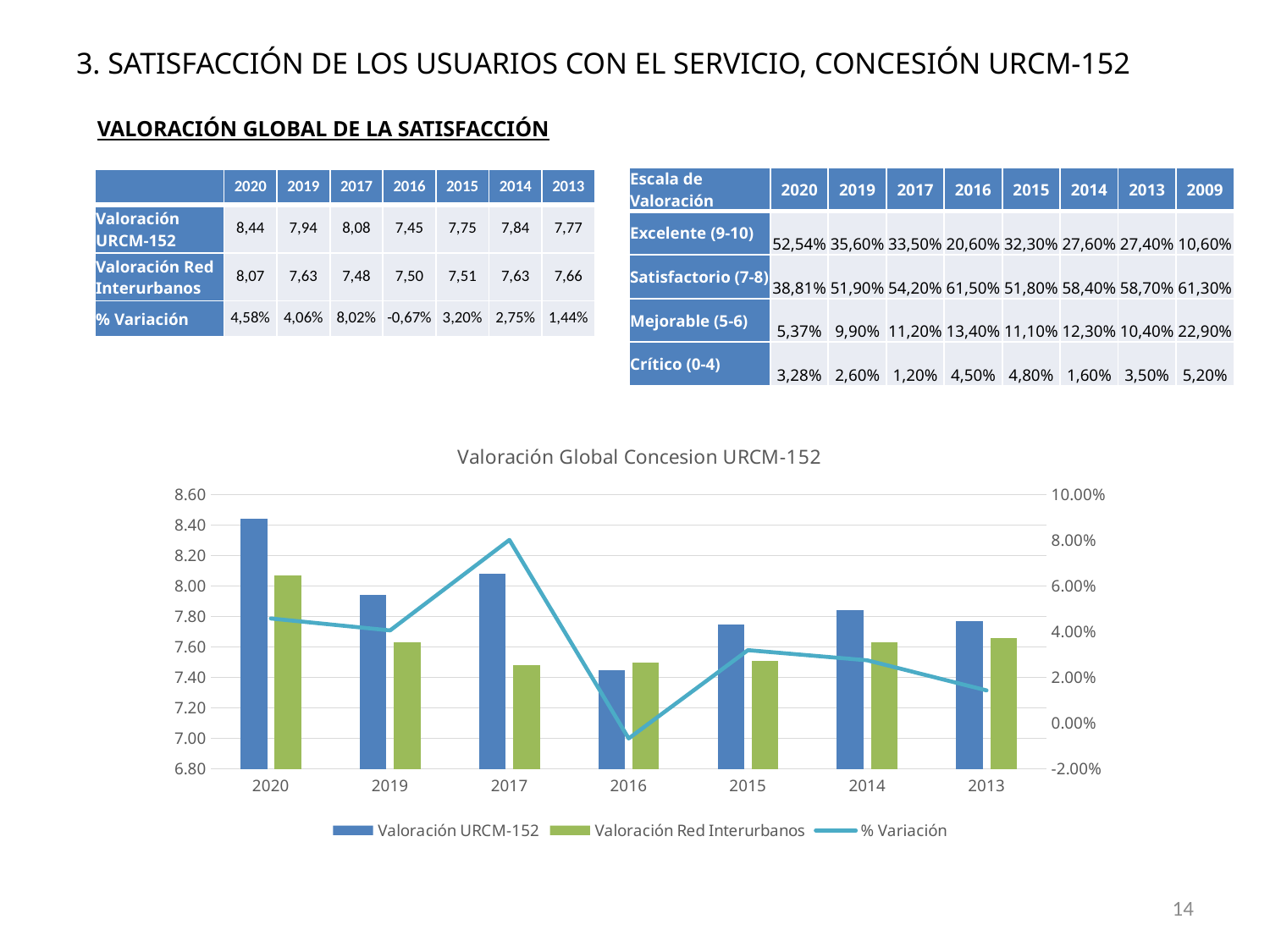
In which year does the % Variación line reach its lowest point? 2016 How many series does the chart's legend list? 3 In which year is the Valoración URCM-152 bar the lowest? 2016 In which year does the % Variación line reach its highest point? 2017 Which series is shown in green in the chart? Valoración Red Interurbanos What kind of chart is shown on the slide? Bar chart with a line series In which year is the Valoración URCM-152 bar the highest? 2020 Which is larger, the Valoración URCM-152 bar for 2017 or for 2019? 2017 What is the title of the chart on the slide? Valoración Global Concesion URCM-152 How many years are shown on the x axis of the chart? 7 Is the Valoración URCM-152 value for 2020 greater or less than 8.20? greater Is the % Variación value for 2016 greater or less than 0.00%? less